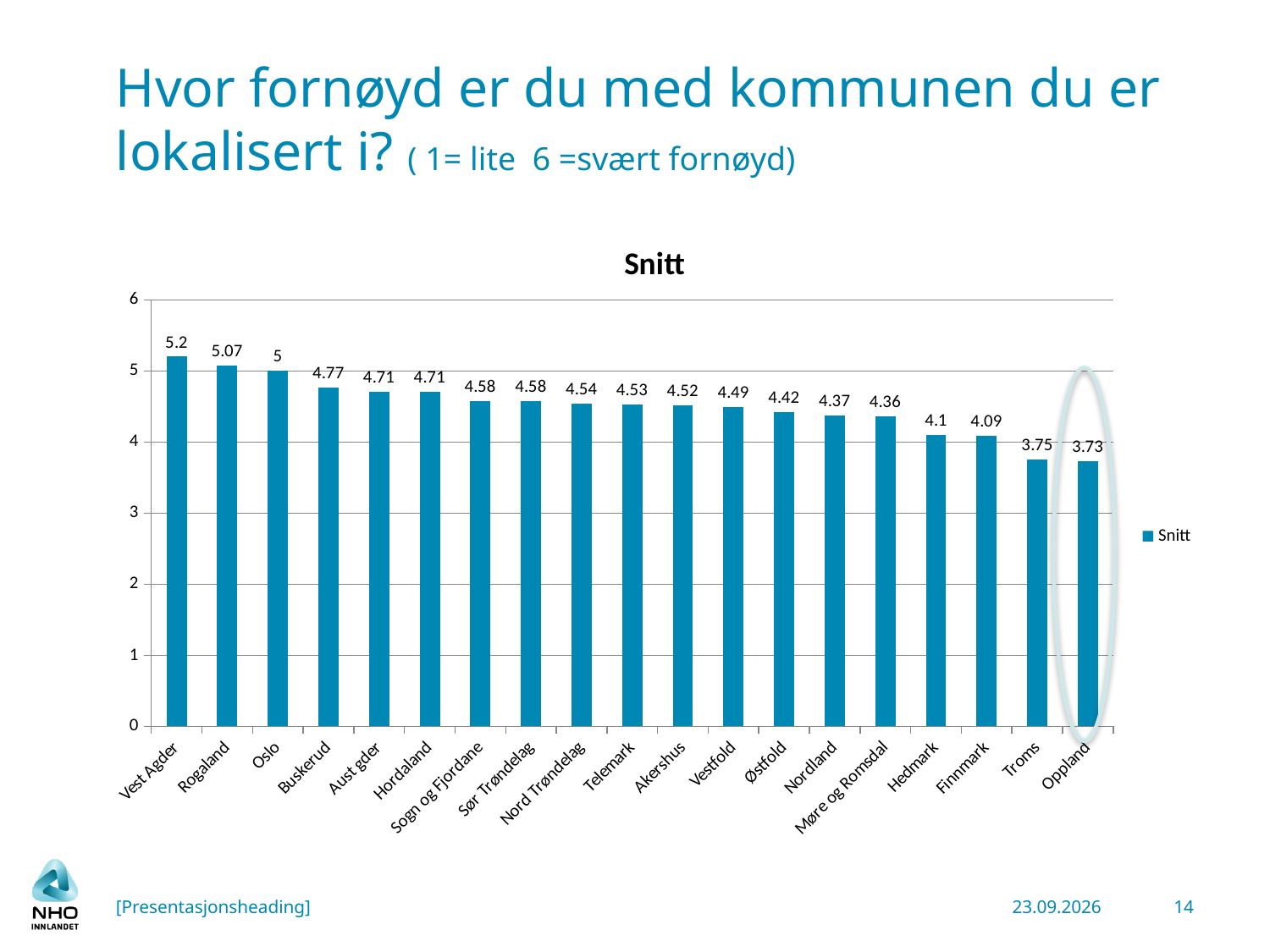
Is the value for Troms greater or less than 4? less What is the value for Hedmark? 4.1 Which is larger, the value for Buskerud or the value for Østfold? Buskerud How many series does the legend list? 1 What is the value for Oppland? 3.73 How many categories are shown on the x axis? 19 Which category has the lowest value? Oppland What is the value for Møre og Romsdal? 4.36 Which category has the highest value? Vest Agder What is the value for Vest Agder? 5.2 What is the difference between the values for Vest Agder and Oppland? 1.47 What kind of chart is shown on the slide? bar chart